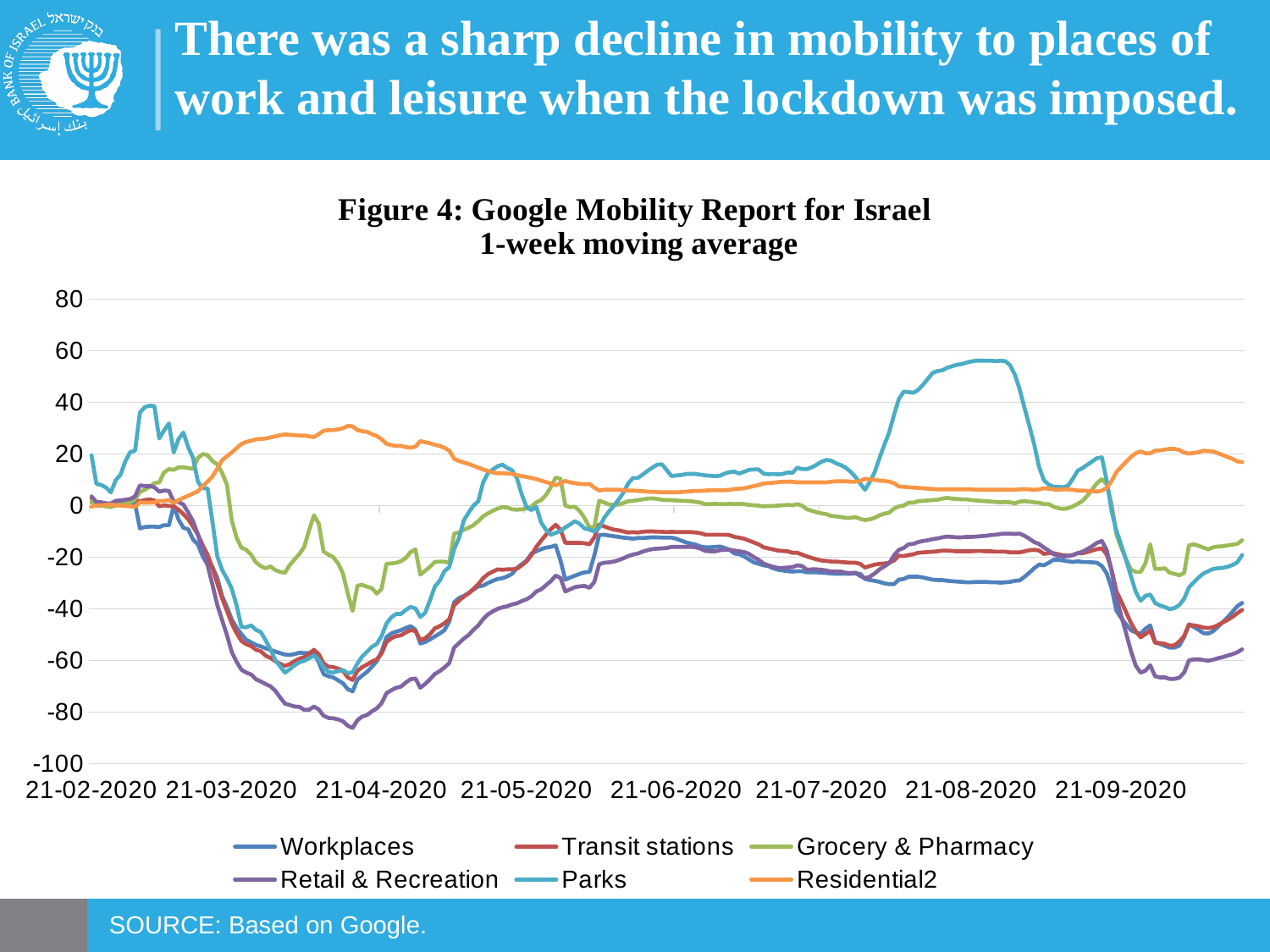
Which series reaches the lowest value on the chart? Retail & Recreation What is the title of the chart? Figure 4: Google Mobility Report for Israel 1-week moving average Is the lowest value of the Retail & Recreation series, reached in early April 2020, greater or less than -80? less What kind of chart is shown on the slide? line chart How many date labels are shown on the x axis? 8 Which series reaches the highest value on the chart? Parks Around 21-08-2020, which series is higher: Parks or Workplaces? Parks Does the Workplaces series rise or fall between 21-03-2020 and 21-04-2020? fall Is the peak value of the Parks series around 21-08-2020 greater or less than 40? greater How many series does the legend list? 6 Is the value of the Residential2 series at 21-04-2020 greater or less than 20? greater Around 21-04-2020, which series is higher: Residential2 or Grocery & Pharmacy? Residential2